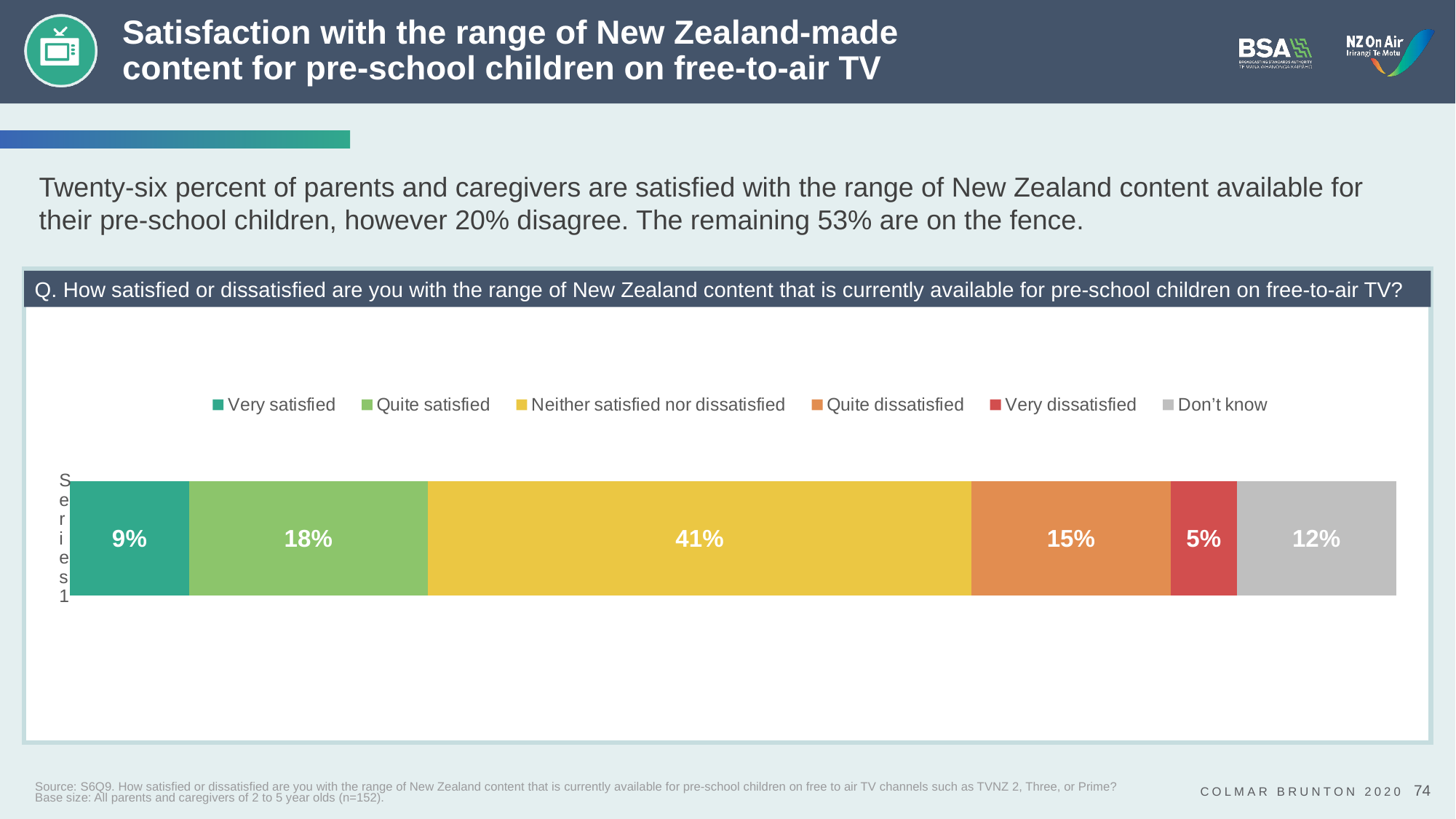
Which response category has the largest share? Neither satisfied nor dissatisfied What percentage of respondents are quite satisfied? 18% Which is larger, the quite dissatisfied share or the don't know share? Quite dissatisfied What kind of chart is shown on the slide? Stacked bar chart Which response category has the smallest share? Very dissatisfied How many series does the legend list? 6 What percentage of respondents are quite dissatisfied? 15% What percentage of respondents answered don't know? 12% What percentage of respondents are very satisfied? 9% What colour represents the 'Neither satisfied nor dissatisfied' segment? Yellow What is the difference between the quite satisfied and very satisfied percentages? 9% What percentage of respondents are neither satisfied nor dissatisfied? 41%